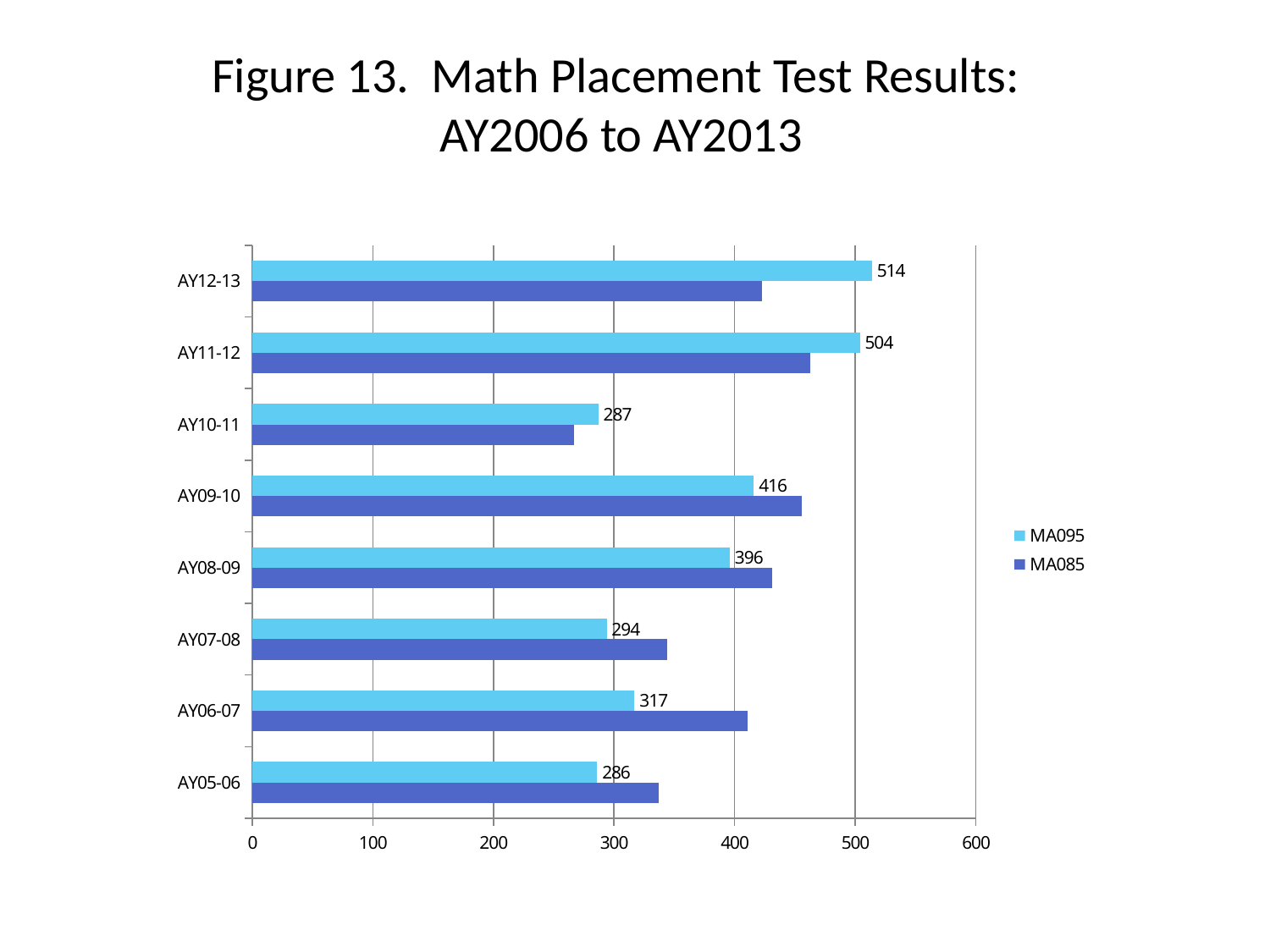
What is the difference between the MA095 values for AY09-10 and AY08-09? 20 What is the difference between the MA095 values for AY12-13 and AY11-12? 10 Is the MA085 value for AY11-12 greater or less than 400? greater How many academic years are shown on the chart? 8 For AY06-07, which series has the larger value, MA095 or MA085? MA085 For AY12-13, which series has the larger value, MA095 or MA085? MA095 How many series does the legend list? 2 What is the MA095 value for AY06-07? 317 What is the MA095 value for AY12-13? 514 Which academic year has the highest MA095 value? AY12-13 What is the MA095 value for AY08-09? 396 Is the MA085 value for AY10-11 greater or less than 300? less